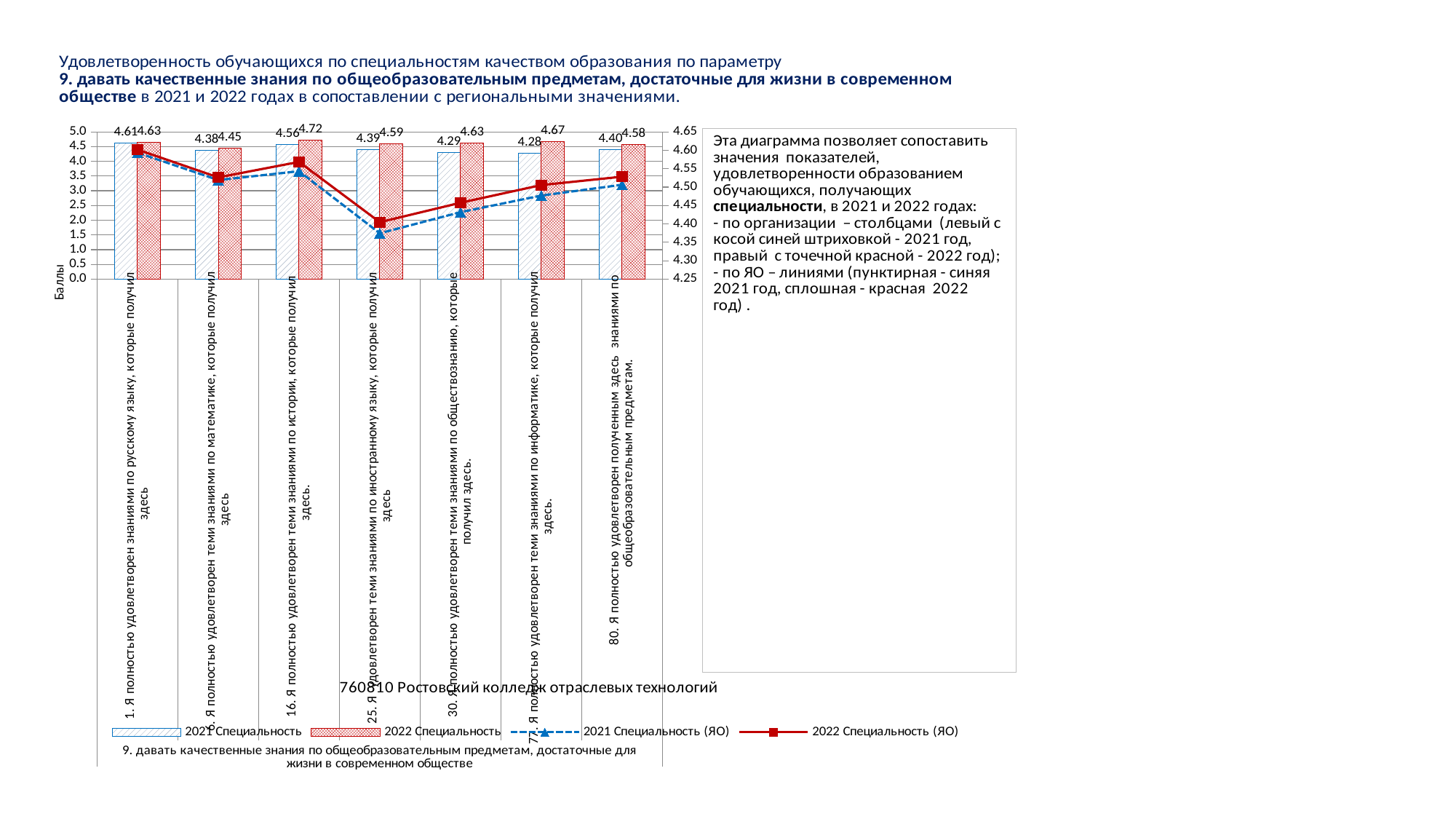
What is the 2022 Специальность value for the category about история (category 16)? 4.72 Is the 2021 Специальность (ЯО) line value for the category about иностранный язык (category 25) greater or less than 4.40 on the right axis? less What is the 2021 Специальность value for the category about русский язык (category 1)? 4.61 What is the difference between the 2022 and 2021 Специальность values for the category about история (category 16)? 0.16 What kind of chart is this? Combined bar and line chart What is the 2021 Специальность value for the category about информатика (category 77)? 4.28 How many series does the legend list? 4 For the category about математика (category 6), which is larger: the 2021 Специальность value or the 2022 Специальность value? 2022 Специальность Which category has the lowest 2021 Специальность value? 77. Я полностью удовлетворен теми знаниями по информатике, которые получил здесь. What is the 2022 Специальность value for the category about обществознание (category 30)? 4.63 How many categories are shown on the x axis? 7 Which category has the highest 2022 Специальность value? 16. Я полностью удовлетворен теми знаниями по истории, которые получил здесь.